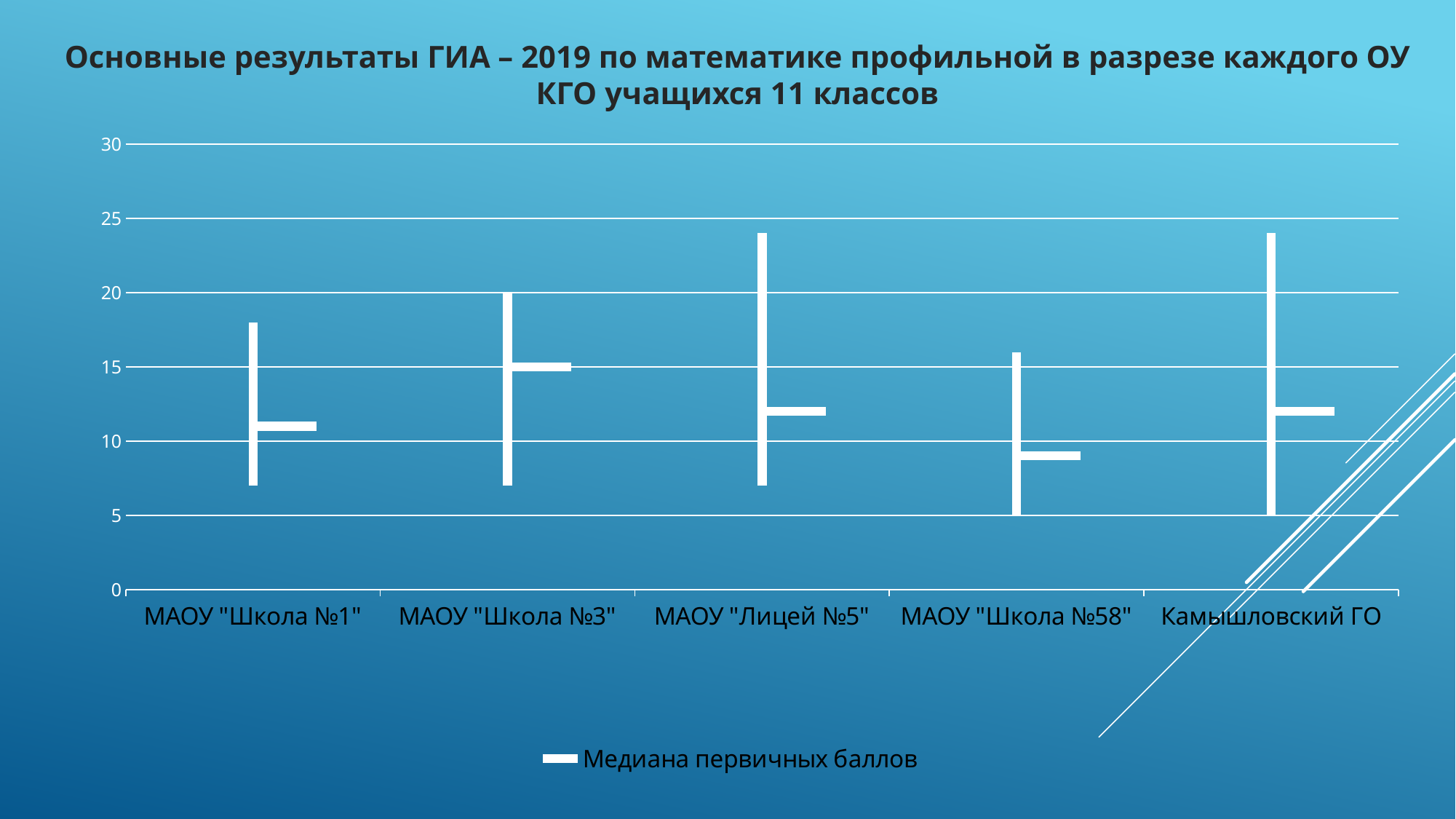
What is the name of the series shown in the legend? Медиана первичных баллов Which school has the highest median primary score marker? МАОУ "Школа №3" What is the maximum value shown on the vertical axis? 30 Which school has the lowest median primary score marker? МАОУ "Школа №58" Is the median primary score for МАОУ "Школа №1" greater or less than 15? less Is the median primary score for Камышловский ГО greater or less than 10? greater How many schools/categories are shown on the x axis? 5 What is the median primary score (Медиана первичных баллов) for МАОУ "Школа №3"? 15 Which has the larger median primary score, МАОУ "Школа №3" or МАОУ "Школа №1"? МАОУ "Школа №3" How many series does the legend list? 1 Is the top of the range line for МАОУ "Лицей №5" greater or less than 20? greater